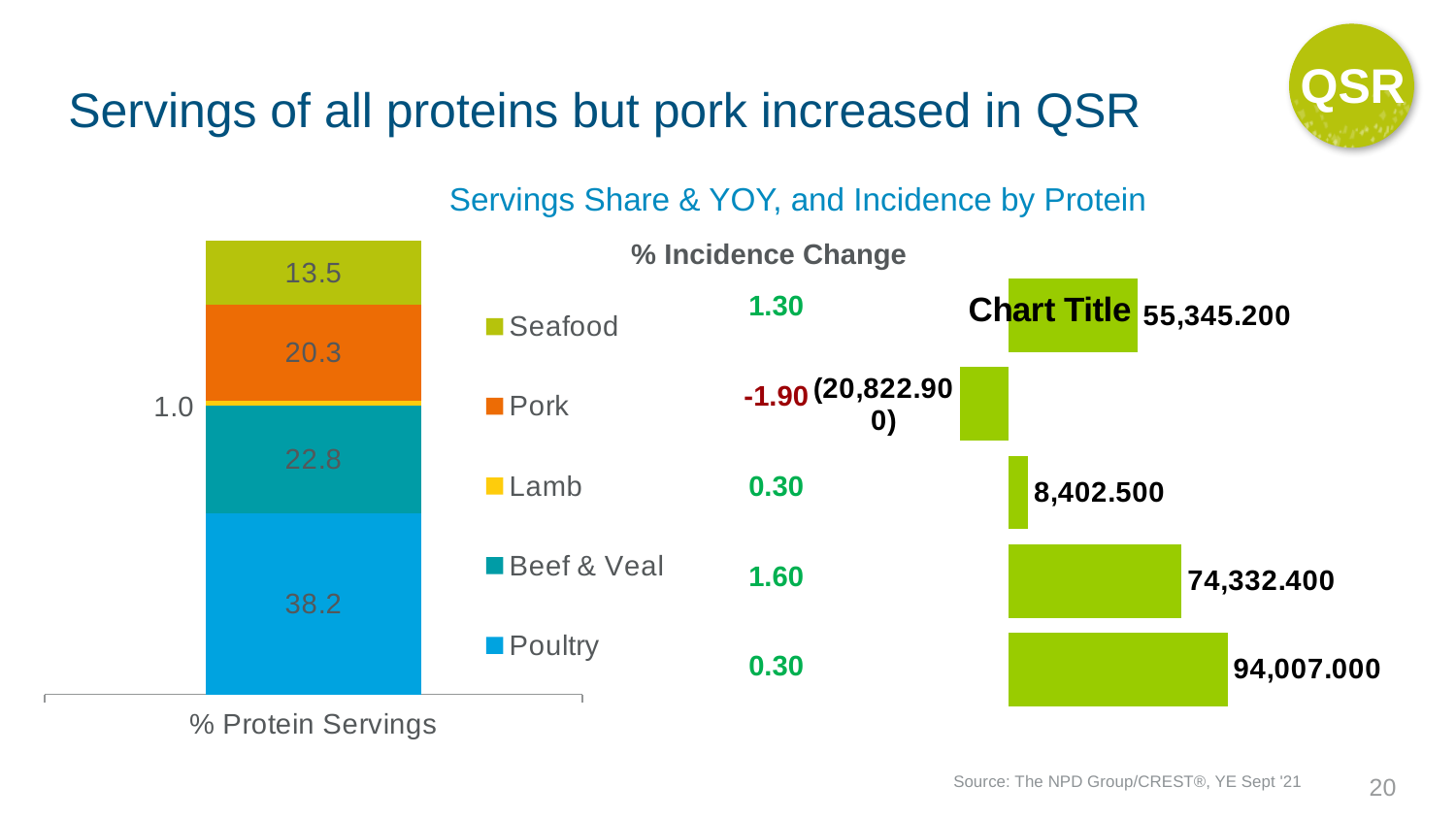
In the stacked bar chart on the left (% Protein Servings), what is the value for Beef & Veal? 22.8 In the stacked bar chart on the left (% Protein Servings), which protein has the largest segment? Poultry How many series does the legend of the stacked bar chart on the left list? 5 In the stacked bar chart on the left (% Protein Servings), what is the value for Seafood? 13.5 In the stacked bar chart on the left (% Protein Servings), what is the value for Pork? 20.3 In the stacked bar chart on the left (% Protein Servings), what is the value for Poultry? 38.2 In the stacked bar chart on the left (% Protein Servings), which protein has the smallest segment? Lamb In the stacked bar chart on the left (% Protein Servings), what is the difference between the Poultry and Seafood values? 24.7 In the bar chart on the right (titled 'Chart Title'), what is the lowest value shown? (20,822.900) In the stacked bar chart on the left (% Protein Servings), which is larger, Pork or Beef & Veal? Beef & Veal In the bar chart on the right (titled 'Chart Title'), what is the largest value shown? 94,007.000 How many bars are plotted in the bar chart on the right (titled 'Chart Title')? 5